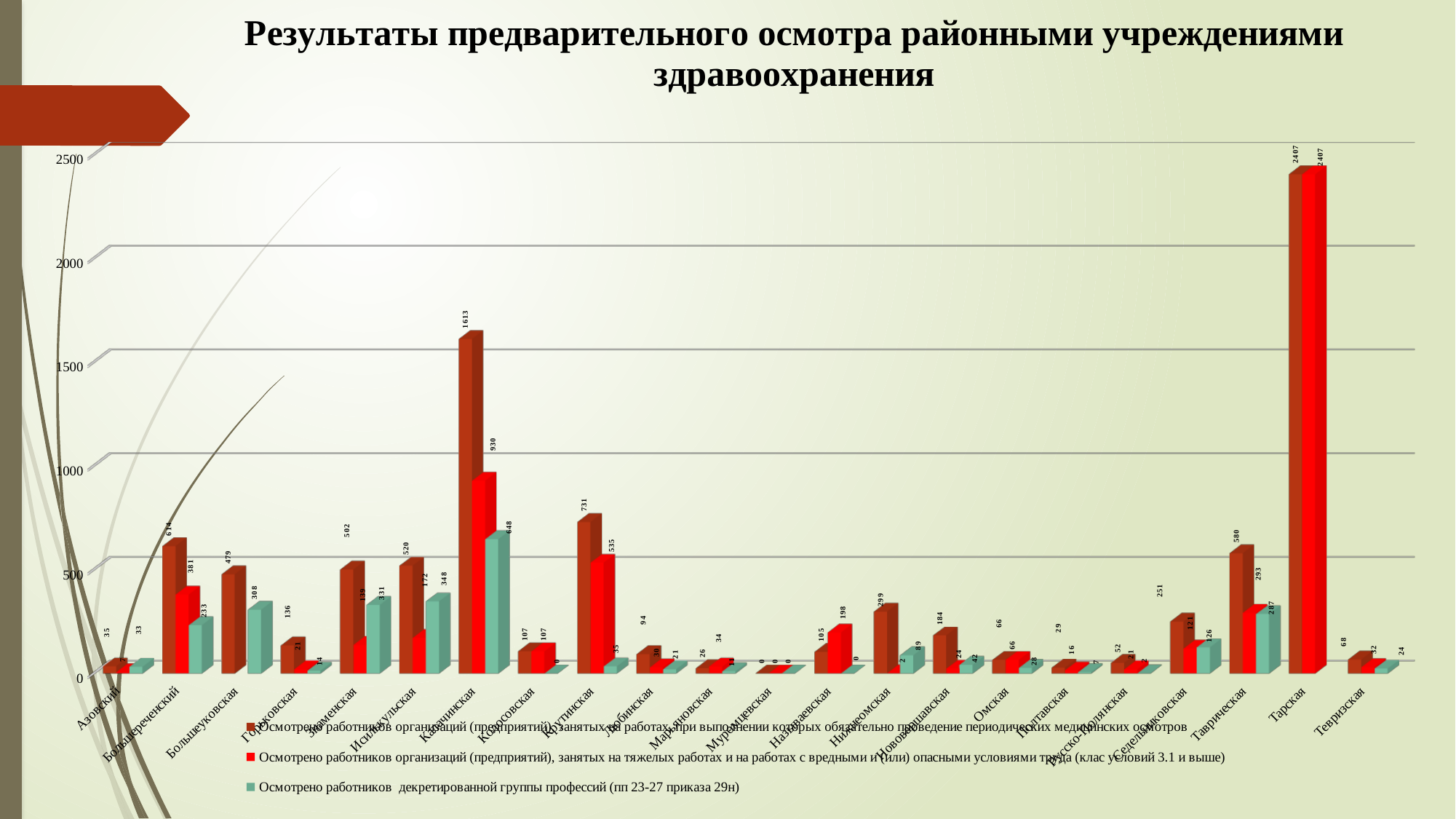
Which district has the highest value in the dark red series (workers subject to mandatory periodic medical examinations)? Тарская What kind of chart is shown on the slide? Bar chart What is the difference between the dark red value (580) and the red value (293) for Таврическая? 287 What is the difference between the dark red value (1613) and the red value (930) for Калачинская? 683 Which has the larger teal value (decreed group of professions): Знаменская or Исилькульская? Исилькульская How many series does the legend list? 3 Is the value of the red series for Тарская greater or less than 2000? greater What is the value of the red series (workers in heavy or hazardous conditions, class 3.1 and above) for Крутинская? 535 What is the value of the dark red series (workers subject to mandatory periodic medical examinations) for Калачинская? 1613 What is the value of the teal series (decreed group of professions) for Седельниковская? 126 What is the title of the chart? Результаты предварительного осмотра районными учреждениями здравоохранения How many districts are shown on the x axis? 22